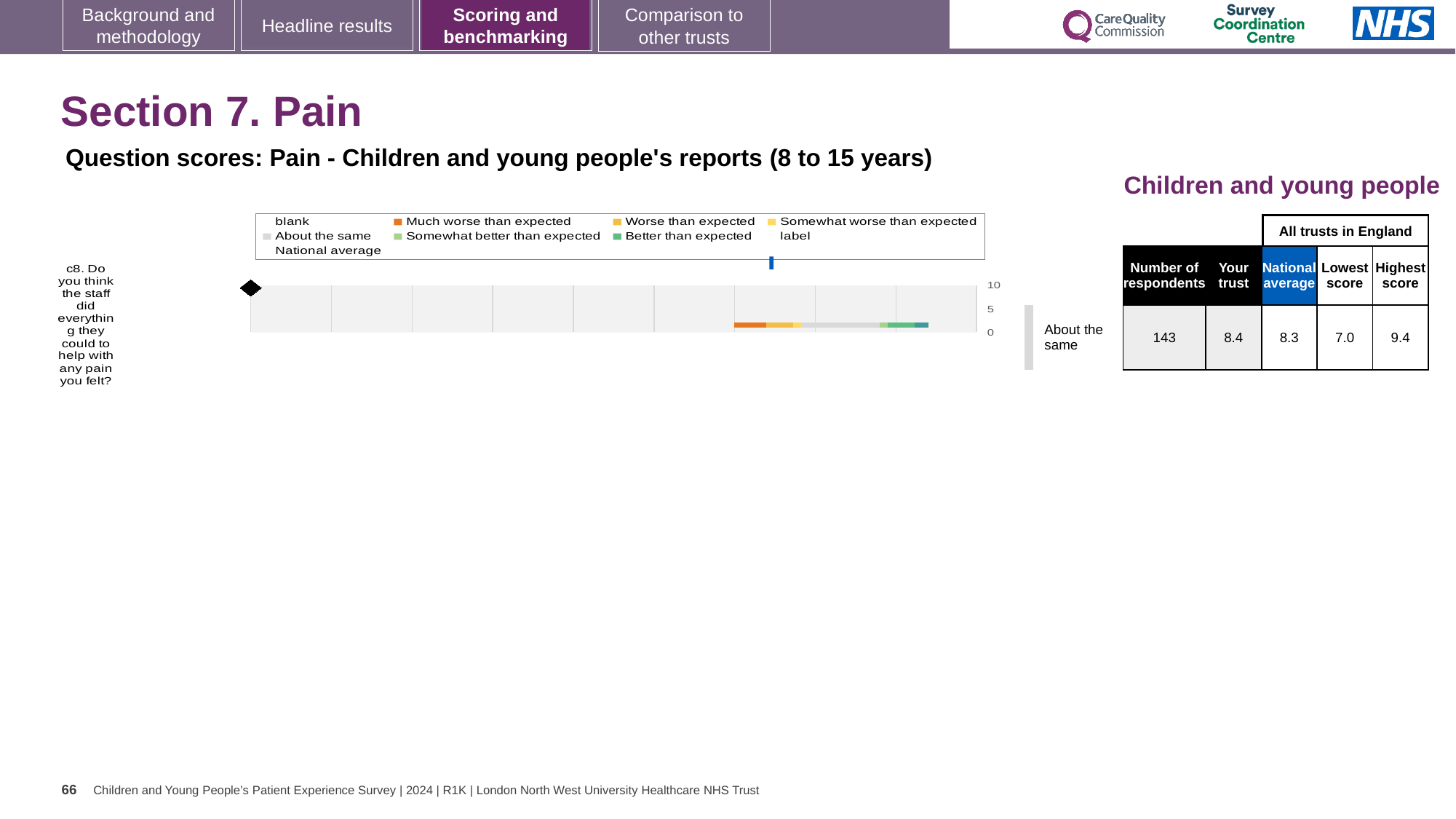
What kind of chart is shown on the slide for question c8? bar chart What is the national average score for question c8? 8.3 What is the difference between the 'Your trust' score and the national average for question c8? 0.1 Which colour does the legend use for 'Much worse than expected'? orange What is the highest score among all trusts in England for question c8? 9.4 What is the difference between the highest score and the lowest score for question c8? 2.4 What benchmark category is the trust's result for question c8 placed in? About the same What is the lowest score among all trusts in England for question c8? 7.0 Which is larger for question c8: the 'Your trust' score or the national average? Your trust How many respondents answered question c8? 143 How many survey questions are plotted in the chart? 1 What is the 'Your trust' score for question c8 (Do you think the staff did everything they could to help with any pain you felt?)? 8.4